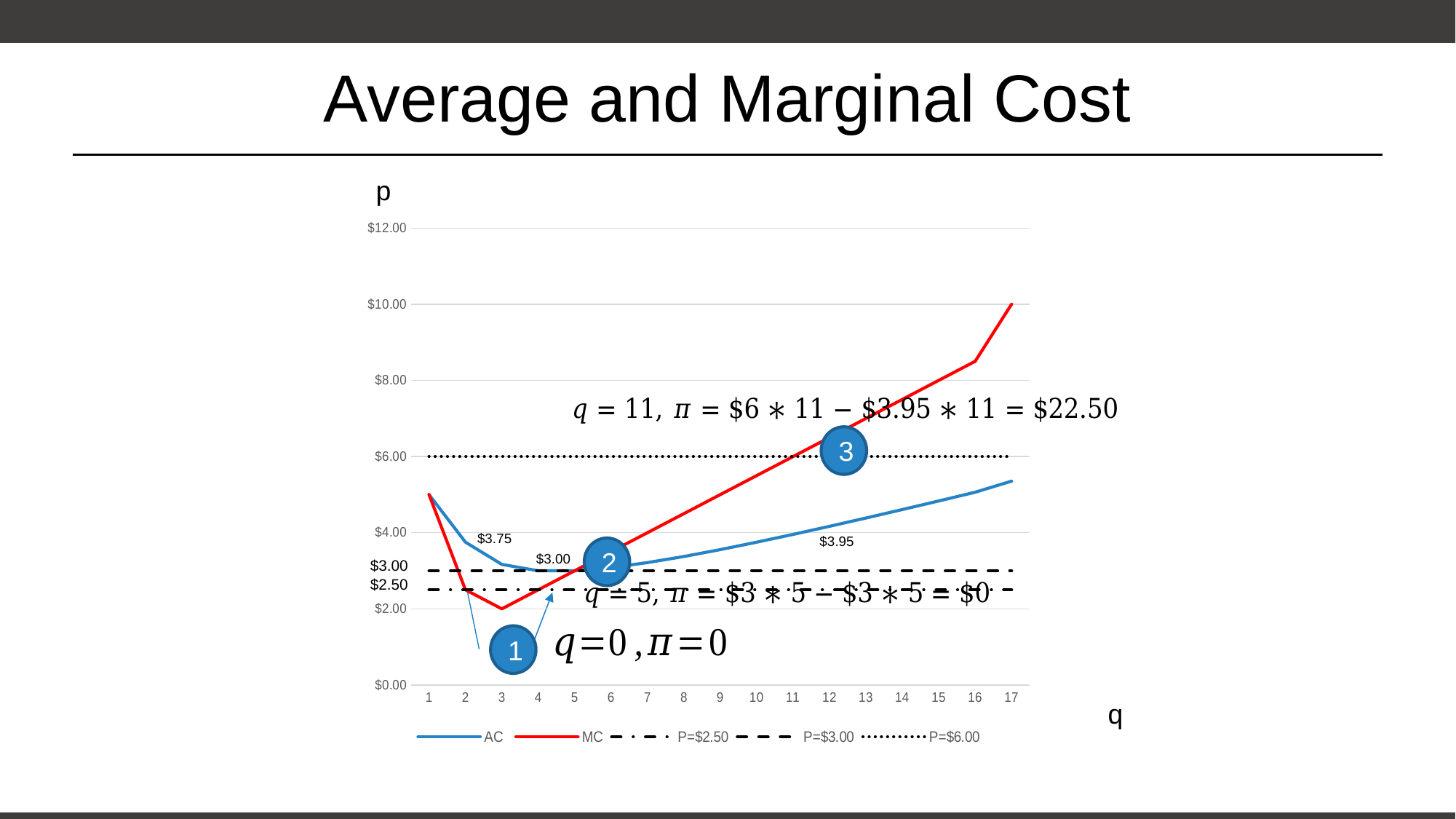
Is the value of AC at q = 17 greater or less than $6.00? less At q = 17, which is larger, MC or AC? MC Is the value of MC at q = 3 greater or less than $4.00? less What is the value of AC at q = 11? $3.95 What kind of chart is shown on the slide? line chart Is the value of MC at q = 16 greater or less than $8.00? greater How many series does the legend list? 5 What is the value of MC at q = 17? $10.00 Which series is drawn as a solid red line? MC What is the value of AC at q = 2? $3.75 How many points are on the x axis (q)? 17 Does the MC line rise or fall from q = 3 to q = 17? rise